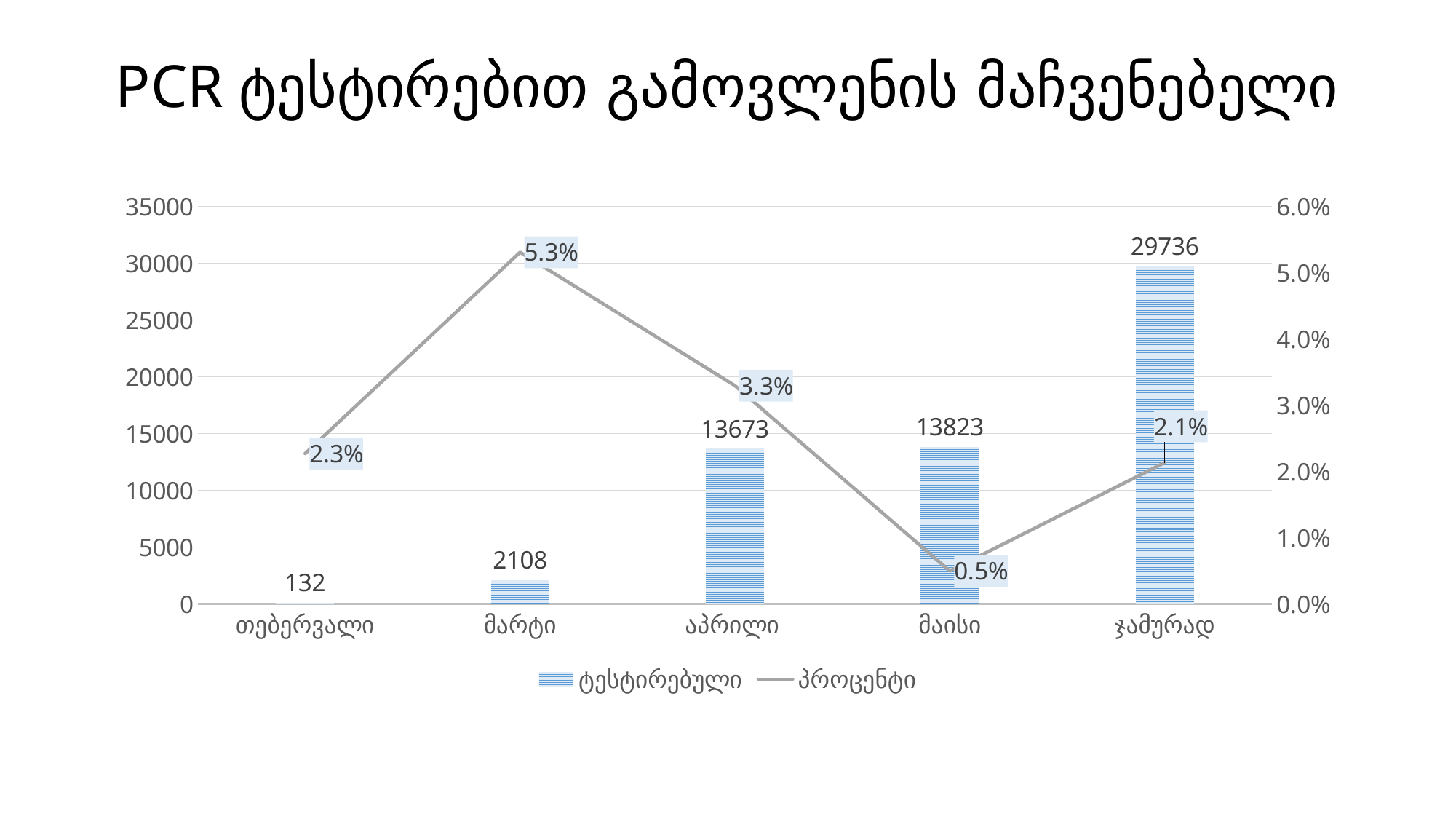
What is the value of ტესტირებული for აპრილი? 13673 Which category has the lowest ტესტირებული value? თებერვალი What is the title of the chart? PCR ტესტირებით გამოვლენის მაჩვენებელი What is the პროცენტი value for ჯამურად? 2.1% Which category has the highest პროცენტი value? მარტი How many series does the legend list? 2 How many categories are shown on the x axis? 5 Which is larger, the პროცენტი value for თებერვალი or for ჯამურად? თებერვალი What is the პროცენტი value for მარტი? 5.3% Which category has the lowest პროცენტი value? მაისი What is the ტესტირებული value for თებერვალი? 132 What is the difference between the ტესტირებული values for მაისი and აპრილი? 150